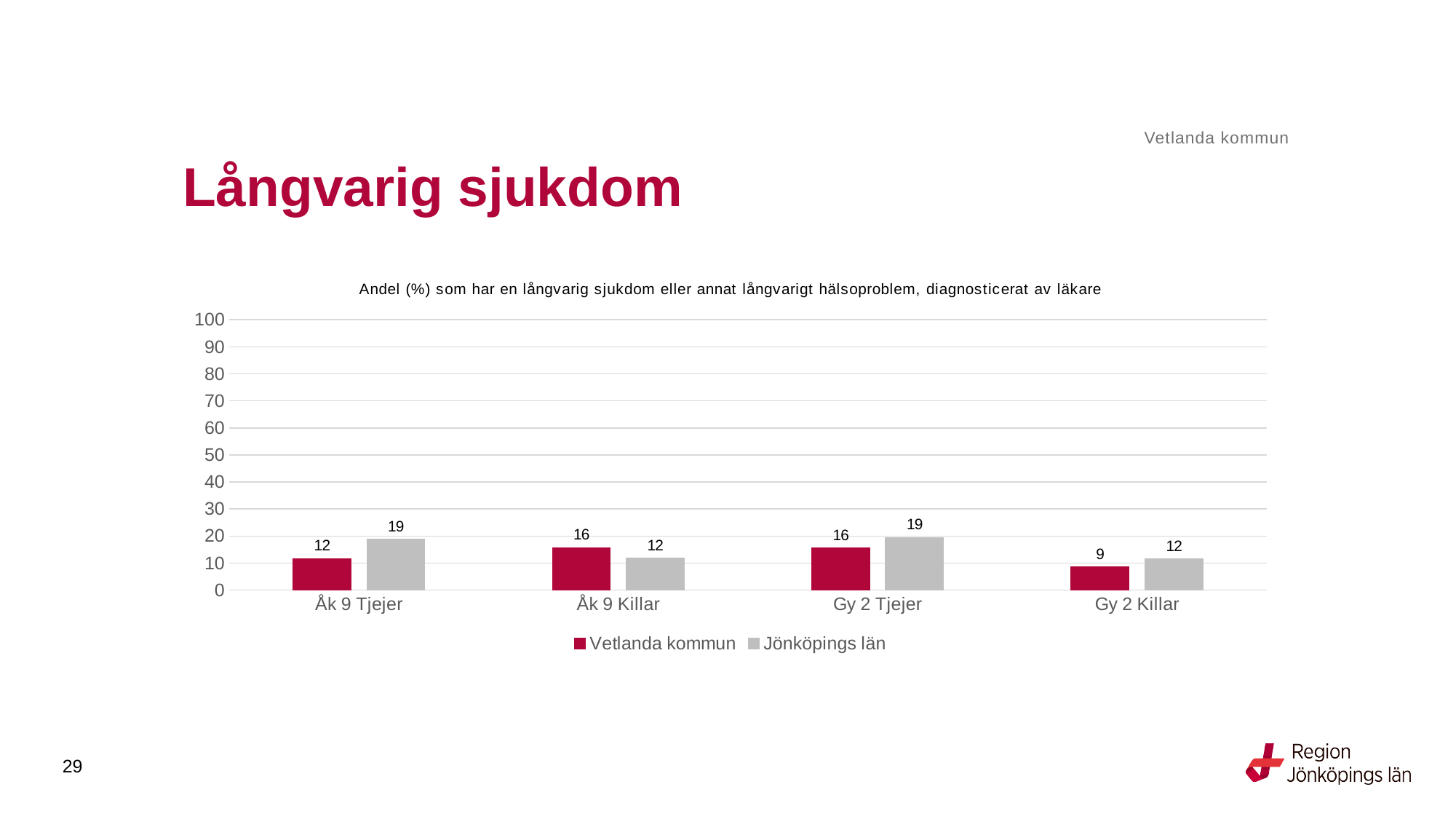
Which is larger in the Åk 9 Killar category: Vetlanda kommun or Jönköpings län? Vetlanda kommun What is the value for Jönköpings län in the Gy 2 Tjejer category? 19 What is the value for Vetlanda kommun in the Gy 2 Killar category? 9 Which category has the highest value for Jönköpings län? Åk 9 Tjejer and Gy 2 Tjejer (both 19) What kind of chart is shown on the slide? Bar chart What is the difference between Jönköpings län and Vetlanda kommun in the Åk 9 Tjejer category? 7 Which colour represents Vetlanda kommun in the chart? Dark red How many series does the legend list? 2 Is the value for Jönköpings län in Gy 2 Killar greater or less than 20? less How many categories are shown on the x axis? 4 Which category has the lowest value for Vetlanda kommun? Gy 2 Killar What is the value for Vetlanda kommun in the Åk 9 Tjejer category? 12